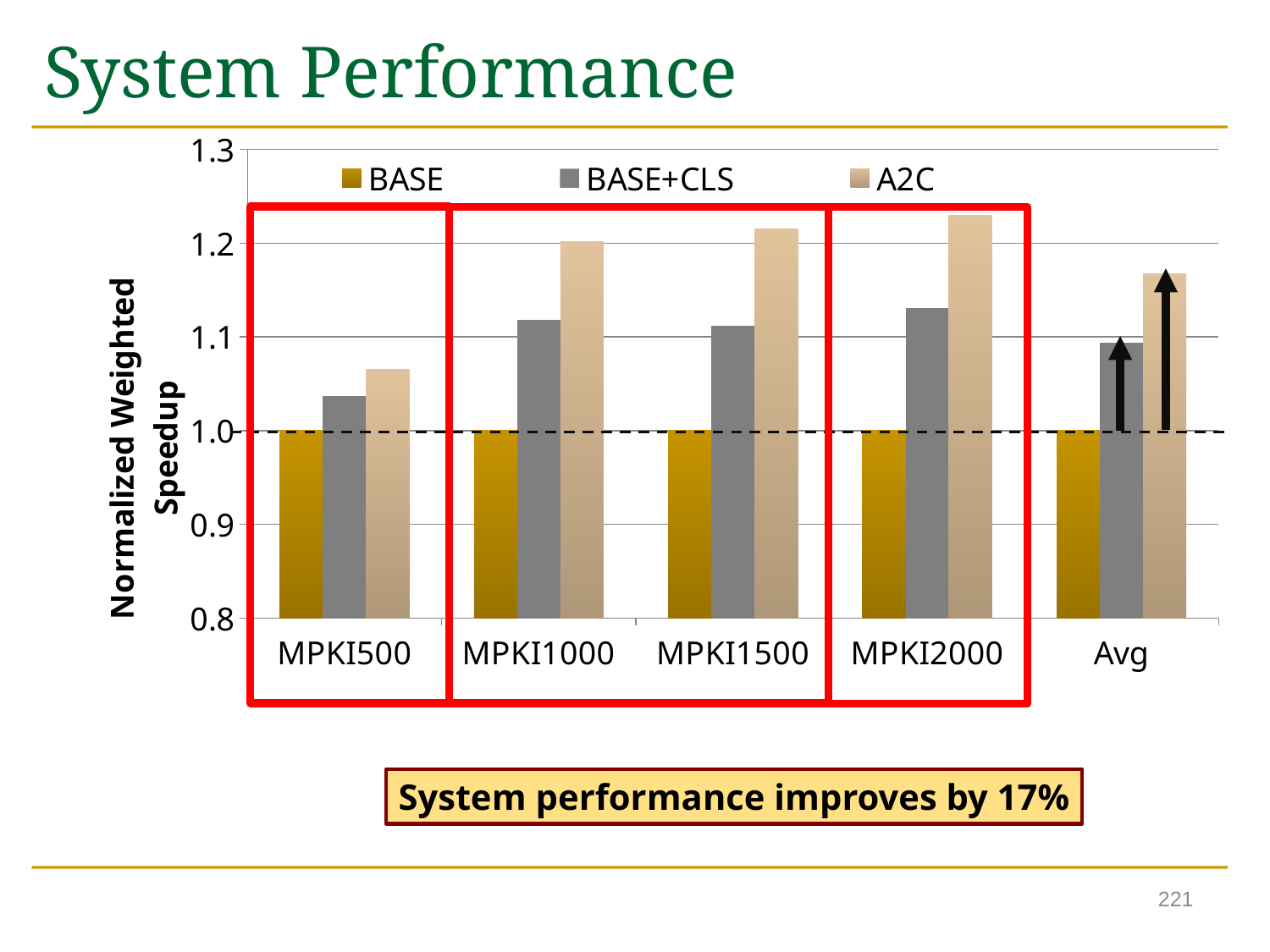
Is the value of BASE+CLS for MPKI1000 greater or less than 1.1? greater For MPKI1000, which is larger: BASE+CLS or A2C? A2C What is the value of BASE for Avg? 1.0 What is the label of the y axis? Normalized Weighted Speedup Do the A2C values rise or fall from MPKI500 to MPKI2000? rise How many series does the legend list? 3 Is the value of A2C for Avg greater or less than 1.2? less For which category is the A2C value lowest? MPKI500 What is the value of BASE for MPKI1000? 1.0 What kind of chart is shown on the slide? bar chart Is the value of A2C for MPKI500 greater or less than 1.1? less How many categories are shown on the x axis? 5